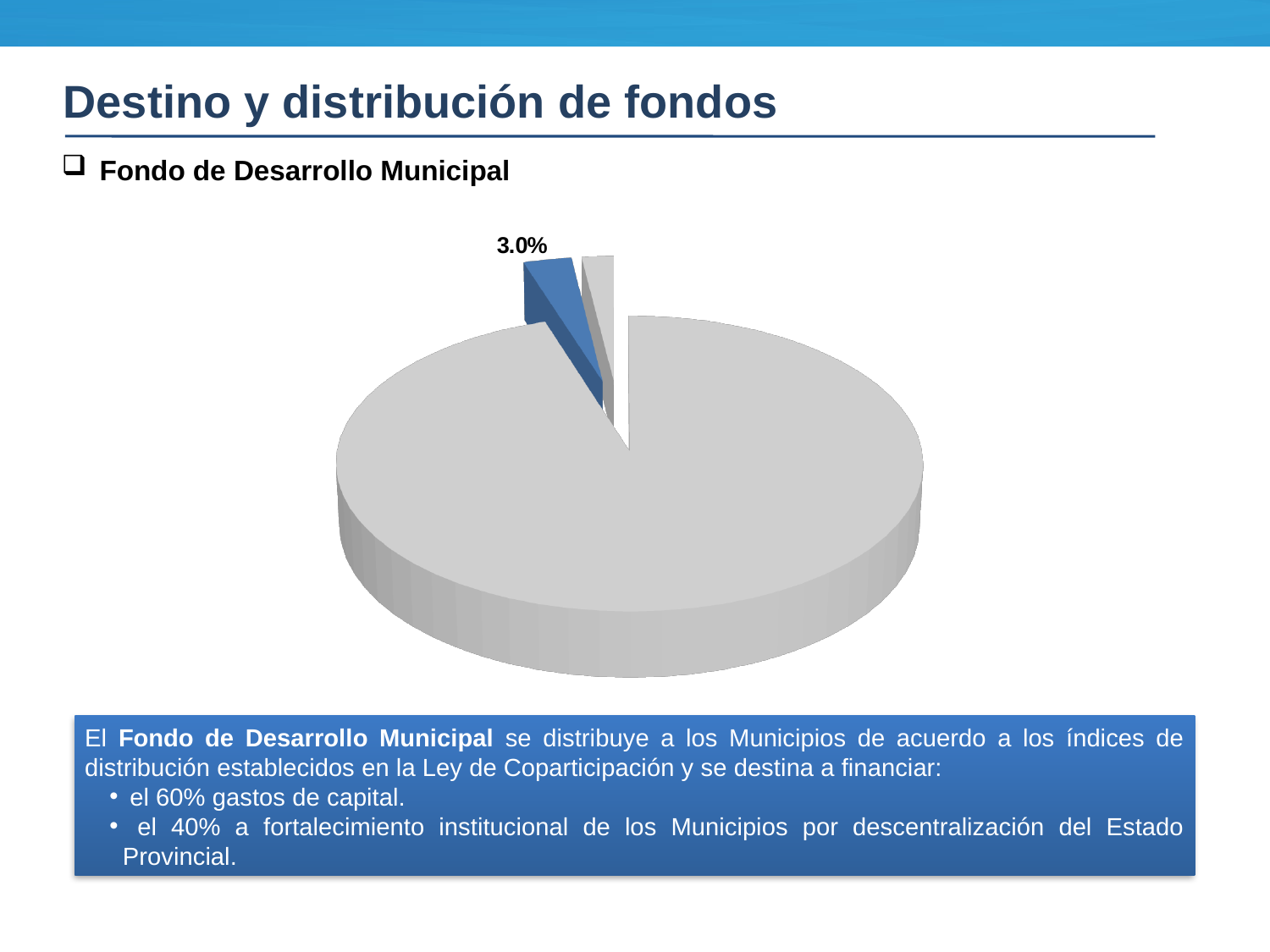
How many slices does the pie chart show? 3 What colour is the slice labelled 3.0% in the pie chart? blue Which slice of the pie chart is the largest: the blue slice or the large grey slice? the large grey slice What kind of chart is shown on the slide? pie chart How many data labels are printed on the pie chart? 1 Is the blue slice labelled 3.0% larger or smaller than the large grey slice? smaller What percentage is printed as the data label on the blue slice of the pie chart? 3.0%